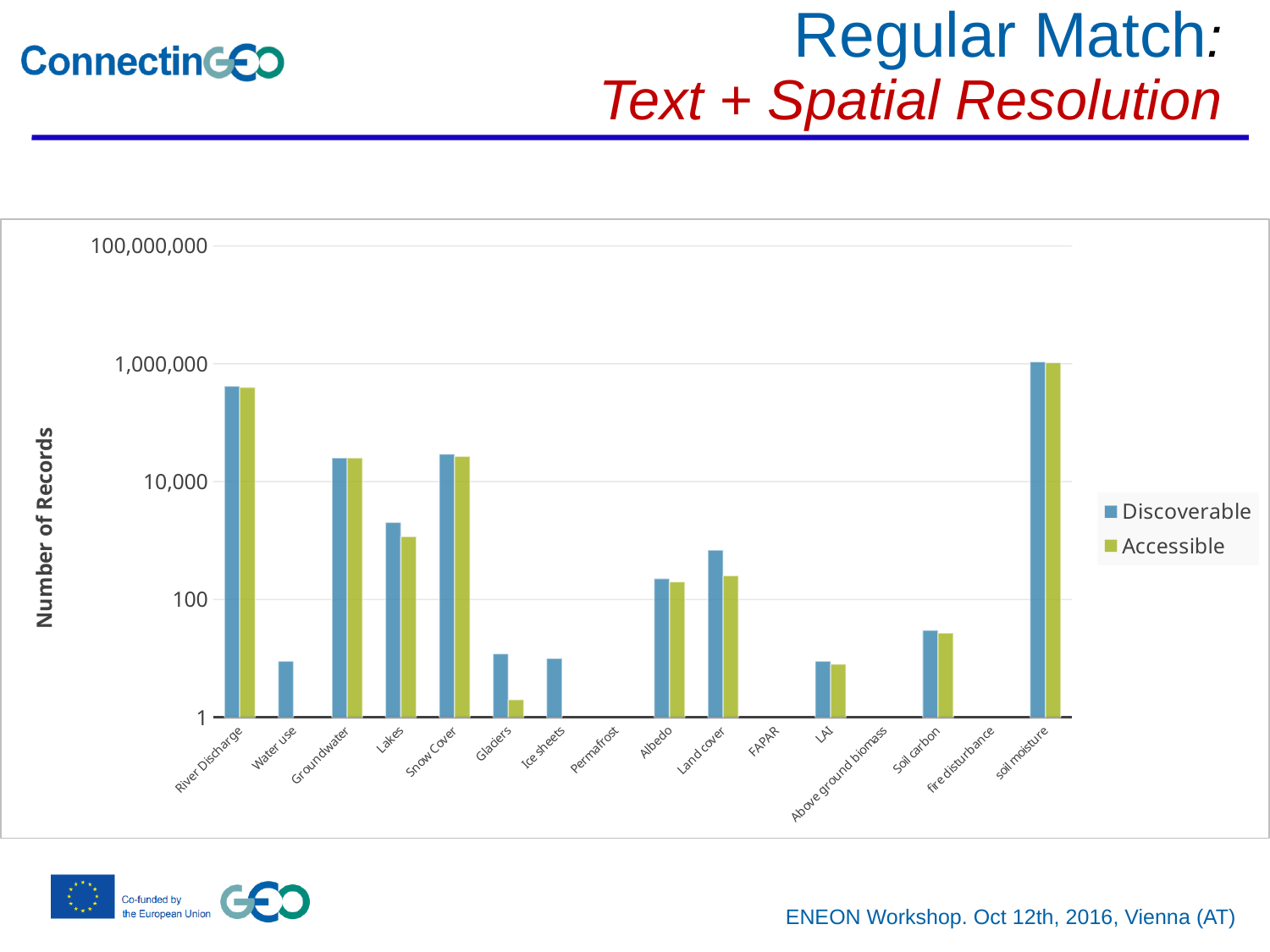
Is the Discoverable value for Glaciers greater or less than 100? less How many categories are shown along the x axis? 16 Is the Discoverable value for Groundwater greater or less than 10,000? greater What is the label on the vertical axis? Number of Records What are the two series named in the legend? Discoverable and Accessible Which category has the highest Discoverable value? soil moisture Which has the larger Discoverable value, Lakes or Land cover? Lakes What kind of chart is shown on the slide? bar chart Is the Discoverable value for Land cover greater or less than 100? greater How many series does the legend list? 2 Which has the larger Discoverable value, River Discharge or Snow Cover? River Discharge